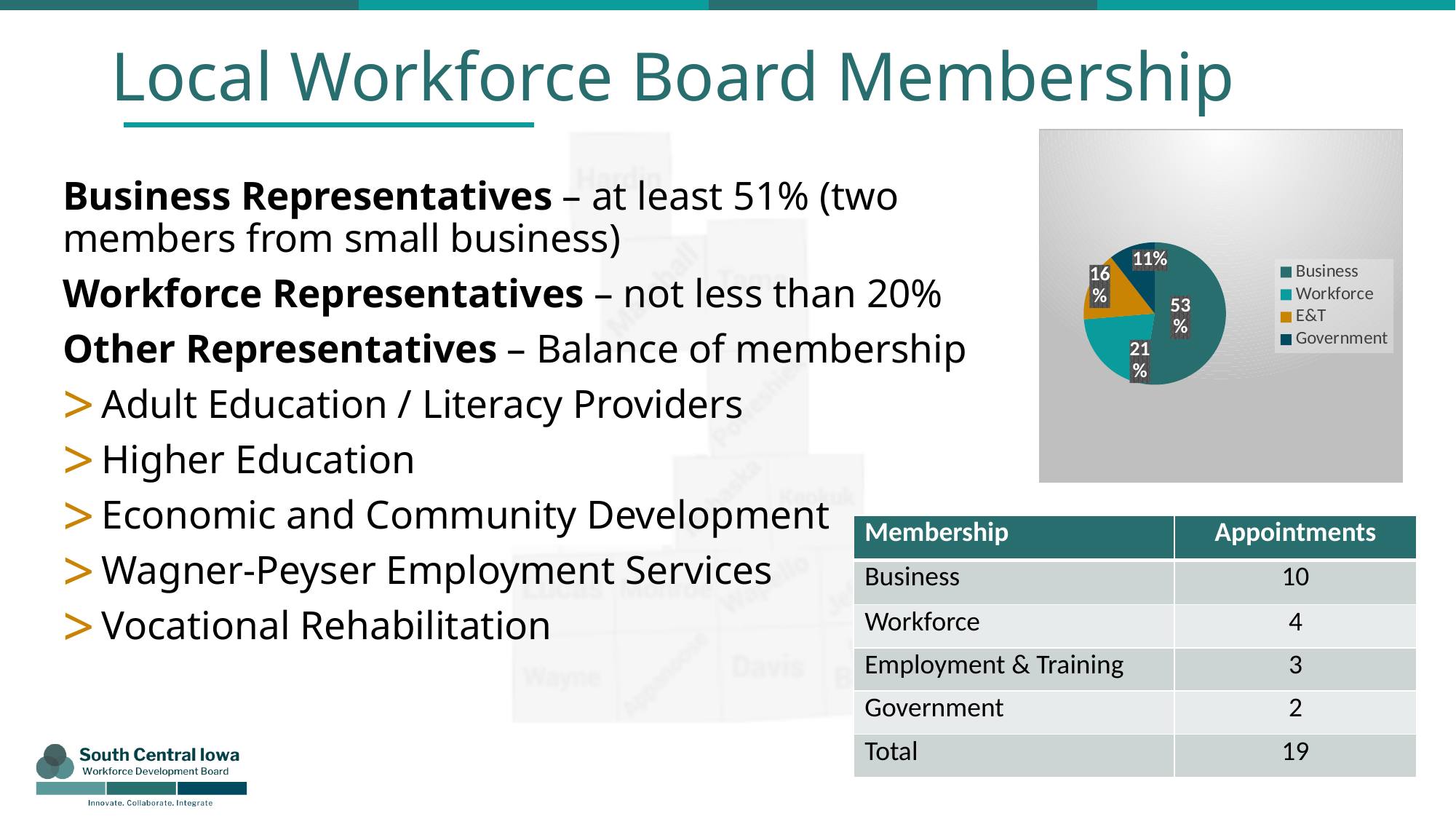
Which category has the smallest slice in the pie chart? Government How many categories does the pie chart show? 4 Which category has the largest slice in the pie chart? Business Which legend entry in the pie chart is shown in orange? E&T How many entries does the pie chart legend list? 4 What share of the pie chart does Workforce represent? 21% What kind of chart is shown on the slide? pie chart What is the difference in percentage points between the Business and Workforce slices? 32 Which slice is larger in the pie chart, E&T or Government? E&T What share of the pie chart does E&T represent? 16% What share of the pie chart does Government represent? 11%